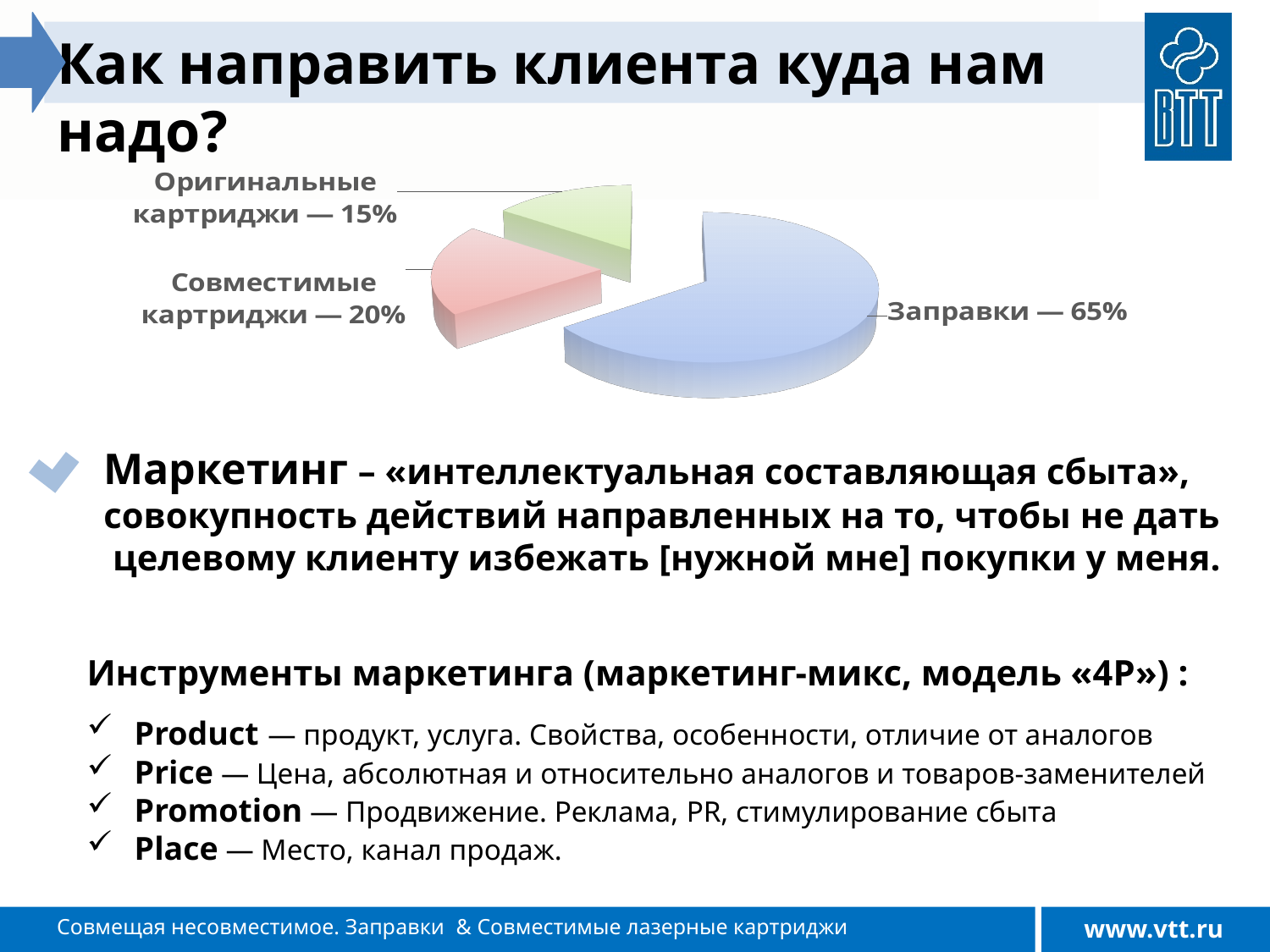
What share of the pie does «Совместимые картриджи» have? 20% What kind of chart is shown on the slide? pie chart What share of the pie does «Оригинальные картриджи» have? 15% What share of the pie does «Заправки» have? 65% What is the difference in percentage points between «Совместимые картриджи» and «Оригинальные картриджи»? 5 Which slice of the pie is the largest? Заправки Which slice of the pie is the smallest? Оригинальные картриджи How many slices does the pie chart have? 3 What is the difference in percentage points between «Заправки» and «Совместимые картриджи»? 45 What colour is the «Оригинальные картриджи» slice of the pie? green Which is larger: the share for «Совместимые картриджи» or for «Оригинальные картриджи»? Совместимые картриджи What colour is the «Заправки» slice of the pie? blue